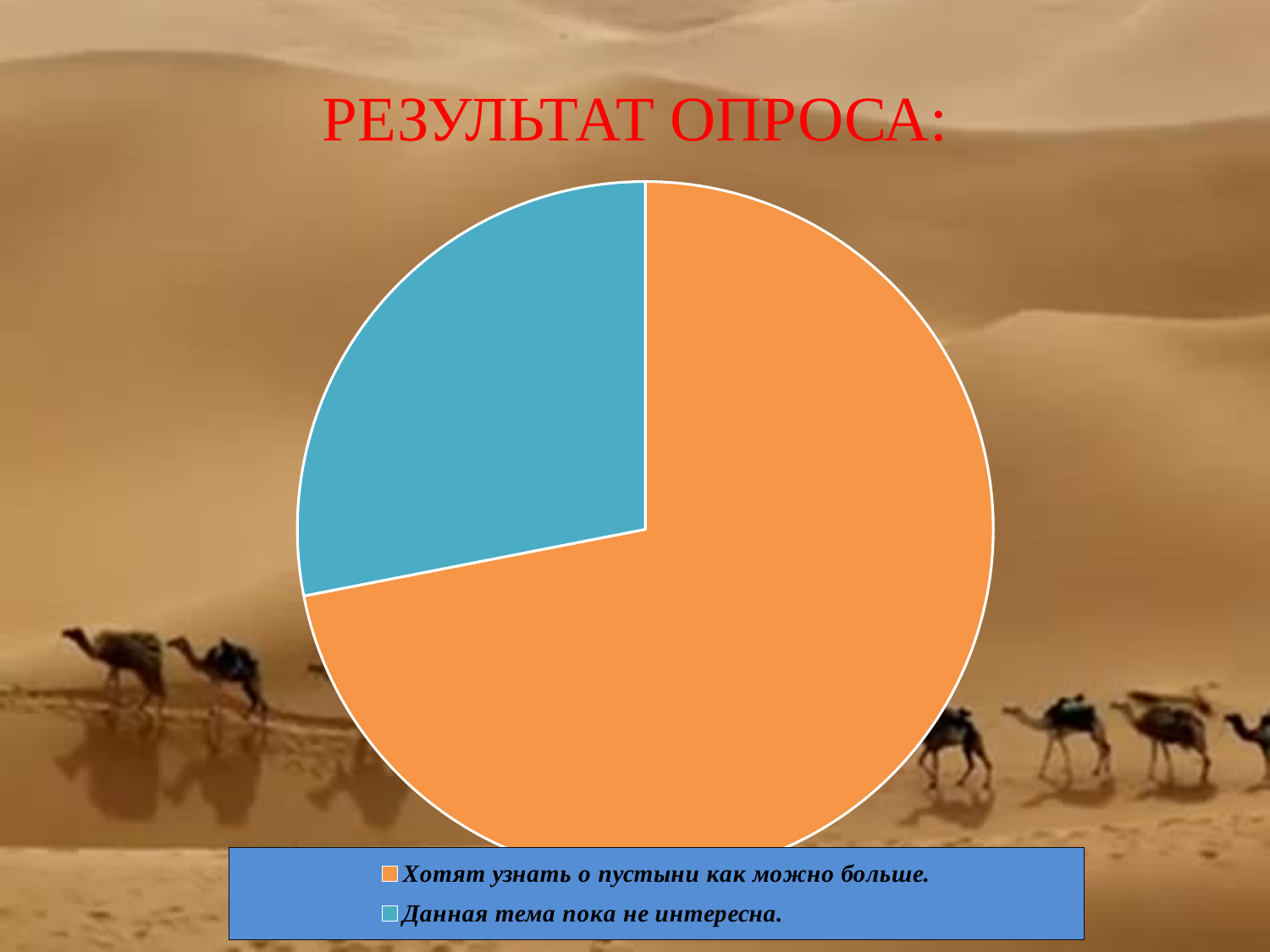
Which category has the smallest slice of the pie? Данная тема пока не интересна. How many slices does the pie chart have? 2 Which category has the largest slice of the pie? Хотят узнать о пустыни как можно больше. What colour is the slice for "Данная тема пока не интересна."? blue How many entries does the legend list? 2 Which slice is larger: "Хотят узнать о пустыни как можно больше." or "Данная тема пока не интересна."? Хотят узнать о пустыни как можно больше. What kind of chart is shown on the slide? pie chart What is the title of the slide above the chart? РЕЗУЛЬТАТ ОПРОСА: